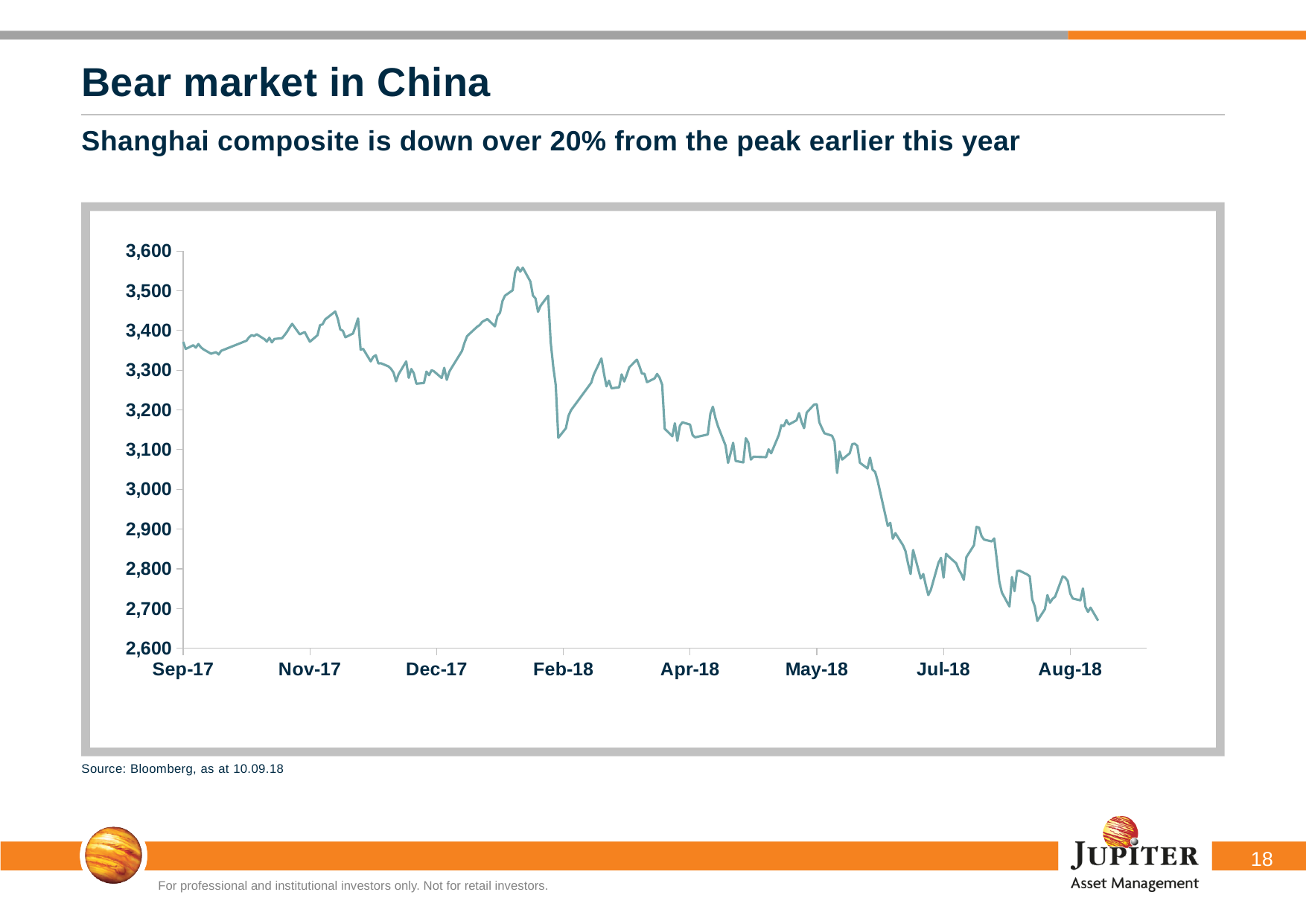
Overall, does the line rise or fall from Sep-17 to Aug-18? fall Is the highest point of the line greater or less than 3,500? greater Is the lowest point of the line greater or less than 2,800? less Which is higher, the value at Sep-17 or the value at Aug-18? Sep-17 Is the value at Aug-18 greater or less than 2,800? less How many date labels are shown on the x axis? 8 What is the highest value shown on the y axis? 3,600 What kind of chart is shown on the slide? line chart What is the source cited for the chart? Bloomberg, as at 10.09.18